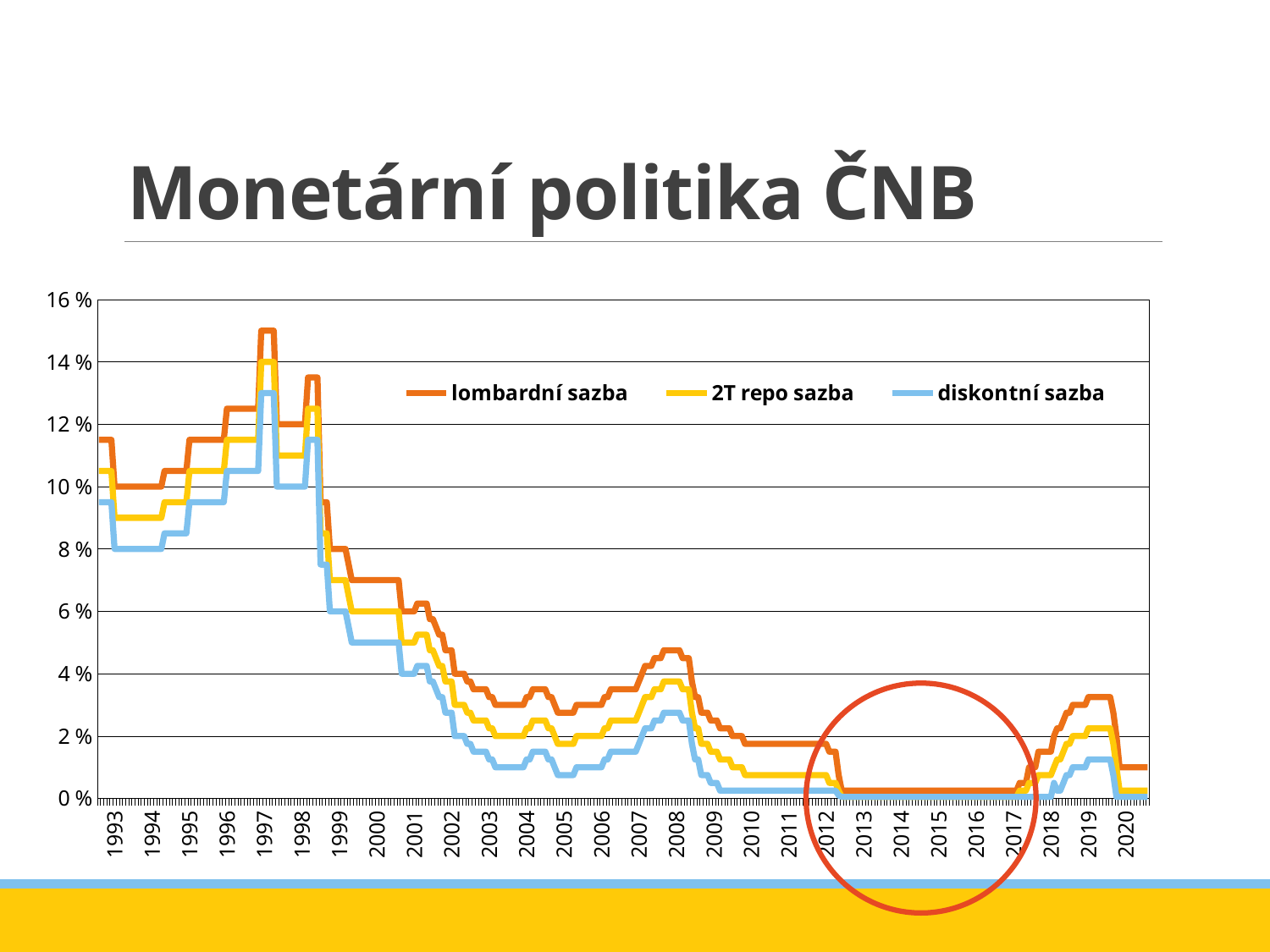
Do the interest rates generally rise or fall from 1993 to 2020? fall What kind of chart is shown on the slide? line chart How many series does the legend list? 3 What are the three series named in the legend? lombardní sazba, 2T repo sazba, diskontní sazba How many year labels are shown on the x axis? 28 Which series has the highest values across the whole period? lombardní sazba In 1997, which is larger: lombardní sazba or diskontní sazba? lombardní sazba Which series has the lowest values across the whole period? diskontní sazba What is the title of the slide containing the chart? Monetární politika ČNB Is the value of diskontní sazba in 2003 greater or less than 2%? less Is the peak value of lombardní sazba in 1997 greater or less than 14%? greater Is the peak value of 2T repo sazba in 2019 greater or less than 4%? less